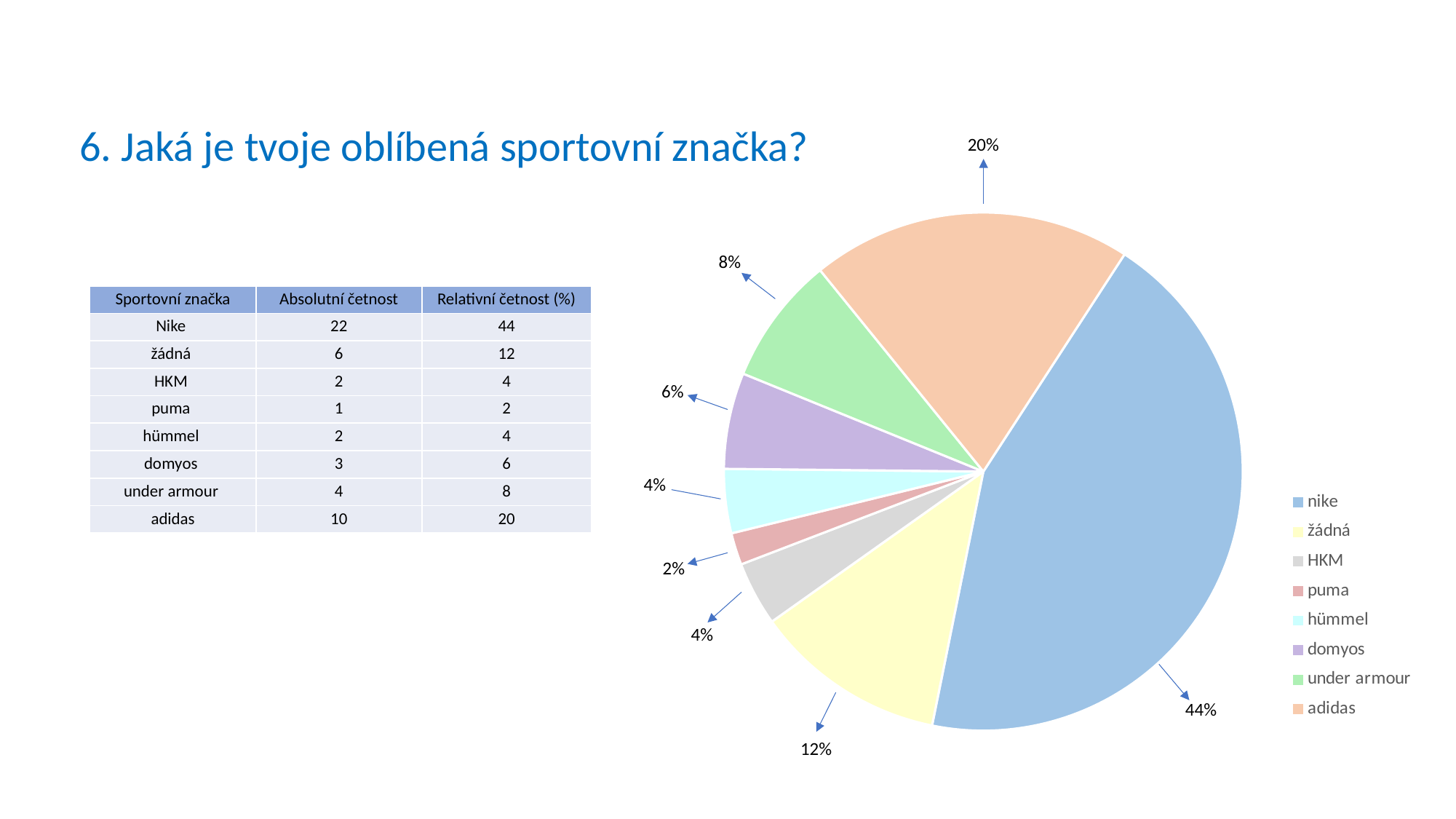
Which category has the largest slice of the pie? nike What share of the pie does the nike slice represent? 44% What share of the pie does the domyos slice represent? 6% What is the difference in percentage points between the nike slice and the adidas slice? 24 What kind of chart is shown on the slide? pie chart How many categories does the legend of the pie chart list? 8 Which category has the smallest slice of the pie? puma What share of the pie does the adidas slice represent? 20% Which slice is larger, žádná or under armour? žádná